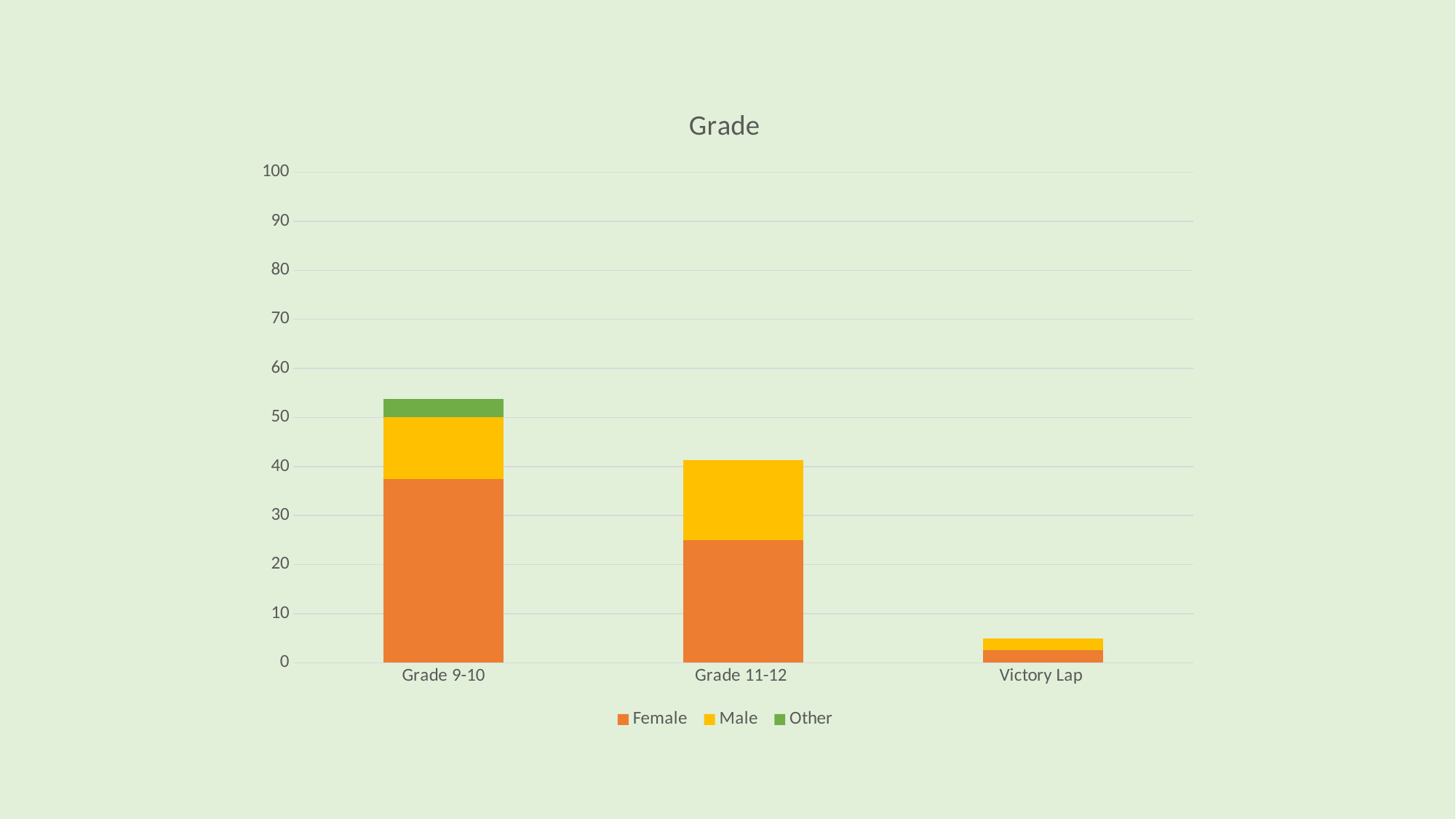
What kind of chart is shown on the slide? stacked bar chart Is the total stacked bar for Grade 11-12 greater or less than 50? less Which category has the tallest stacked bar? Grade 9-10 Which is larger, the Female value for Grade 9-10 or the Female value for Grade 11-12? Grade 9-10 Which category is the only one with a visible Other segment? Grade 9-10 Is the total stacked bar for Grade 9-10 greater or less than 50? greater Is the total stacked bar for Victory Lap greater or less than 10? less Do the total stacked bar heights rise or fall from Grade 9-10 to Victory Lap? fall How many series does the legend list? 3 Which category has the shortest stacked bar? Victory Lap How many categories are shown on the x axis of the chart? 3 What is the title of the chart? Grade